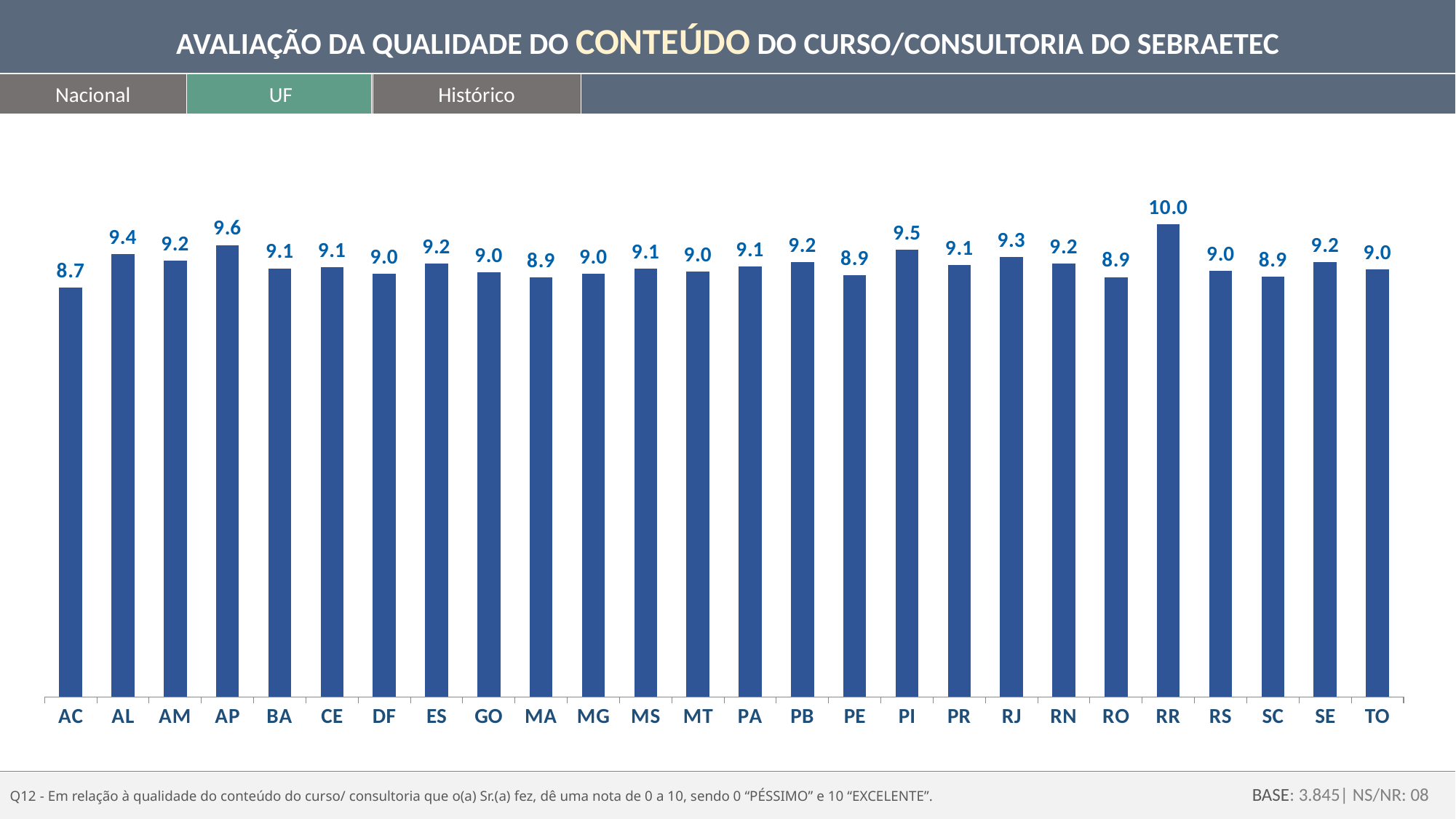
Which state (UF) has the lowest value? AC What is the difference between the values for AP and AL? 0.2 What is the value for RR? 10.0 What is the value for RJ? 9.3 How many states (UFs) are shown on the x axis? 26 Which has a larger value, PI or RJ? PI What is the value for PI? 9.5 Which has a larger value, AP or AL? AP What kind of chart is shown on the slide? Bar chart Which state (UF) has the highest value? RR What is the difference between the values for RR and AC? 1.3 What is the value for AC? 8.7